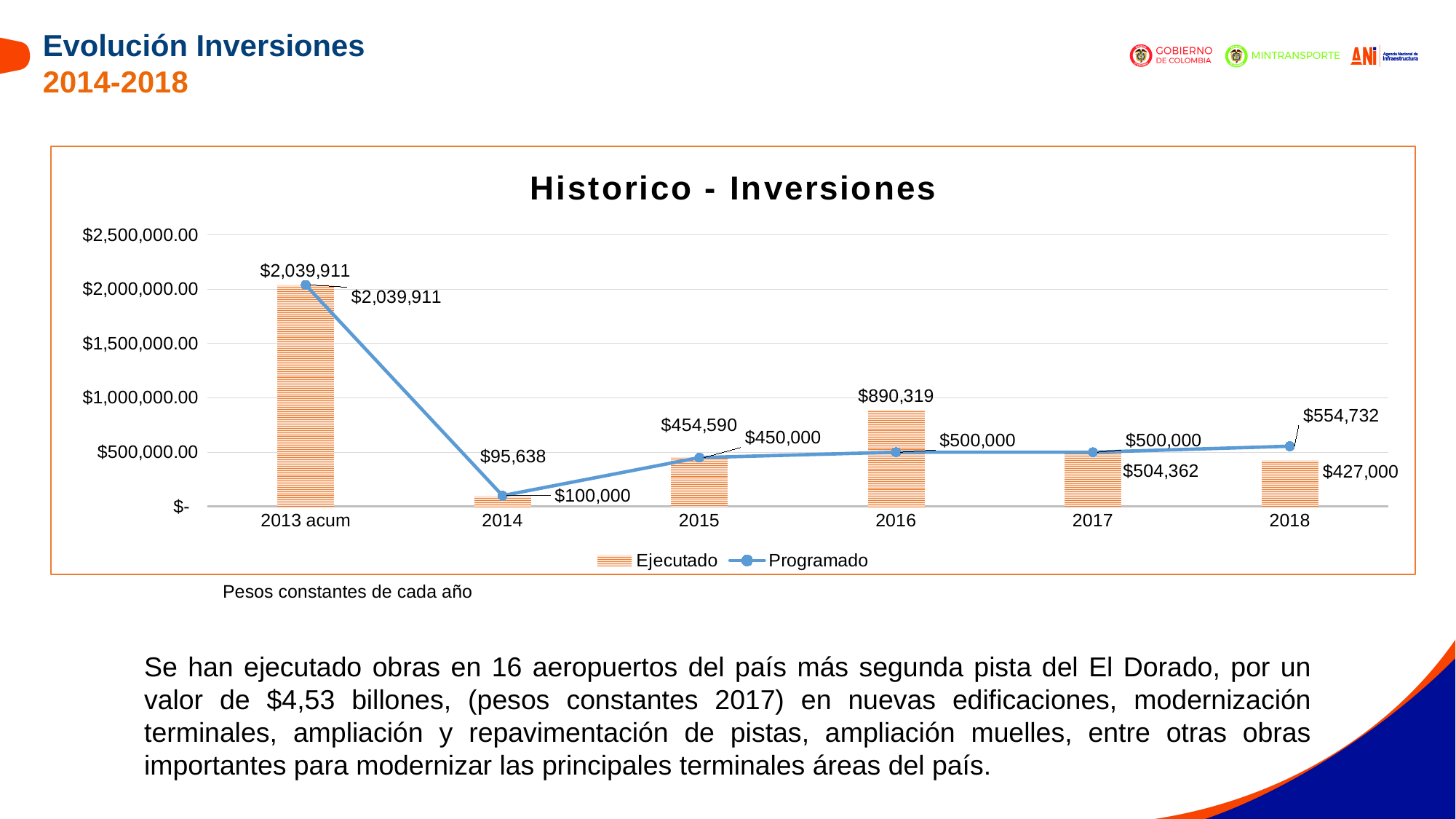
Which category has the highest Ejecutado value? 2013 acum What is the difference between the Ejecutado and Programado values for 2016? $390,319 What is the title of the chart? Historico - Inversiones What is the Ejecutado value for 2016? $890,319 What is the Programado value for 2018? $554,732 For 2018, which is larger, Ejecutado or Programado? Programado How many series does the legend list? 2 Which category has the lowest Ejecutado value? 2014 Does the Programado line rise or fall from 2014 to 2018? Rise What is the Ejecutado value for 2014? $95,638 What kind of chart is shown on the slide? A combined bar and line chart How many categories are shown on the x axis? 6